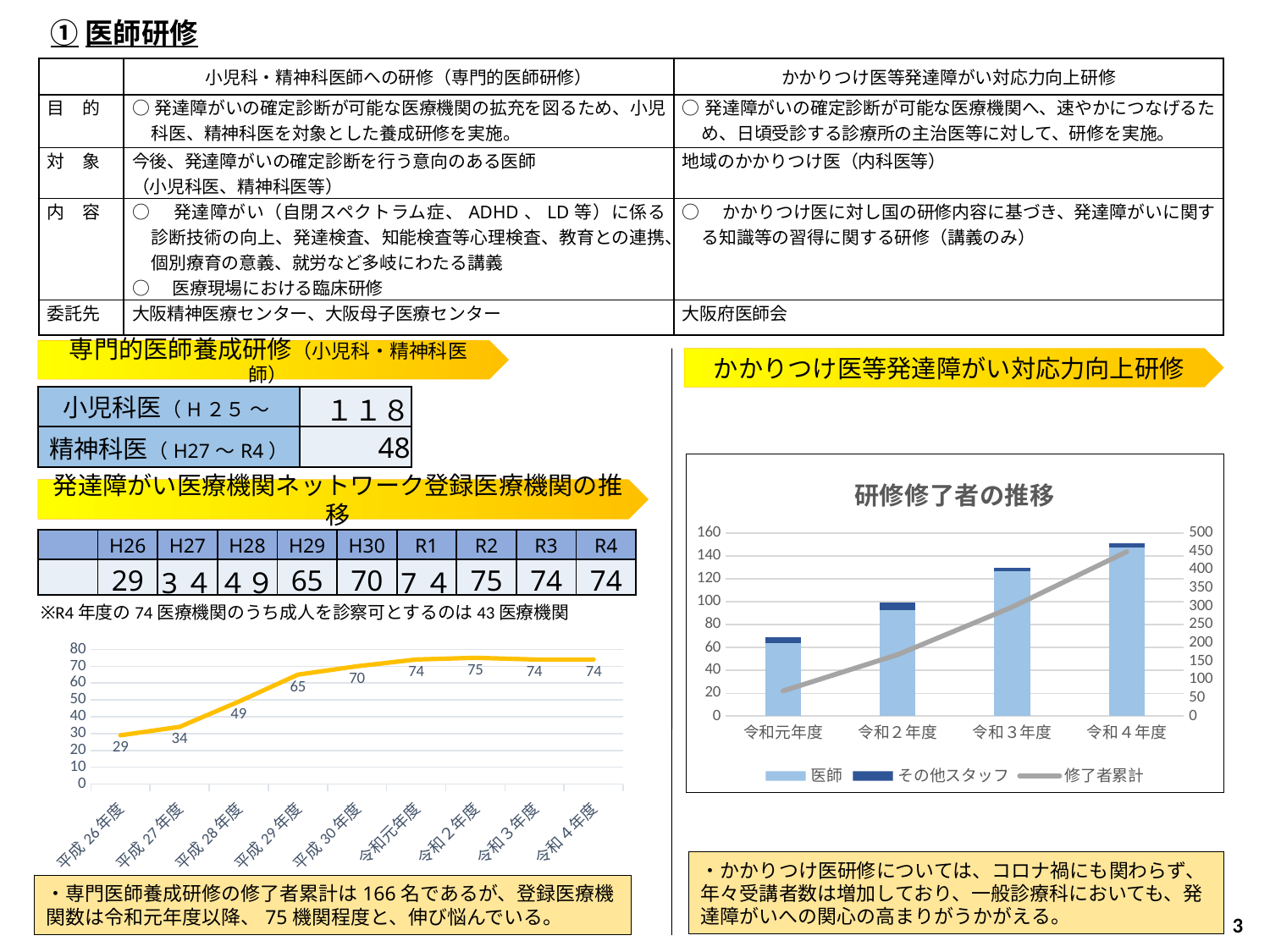
What kind of chart is the chart at the bottom left of the slide (the one with years from 平成26年度 to 令和4年度)? line chart In the bottom-left line chart, what is the difference between the values for 平成29年度 and 平成28年度? 16 In the chart titled 研修修了者の推移, is the total height of the stacked bar for 令和元年度 greater or less than 80? less In the bottom-left line chart, do the values generally rise or fall from 平成26年度 to 令和4年度? rise In the bottom-left line chart, which year has the highest value? 令和2年度 In the bottom-left line chart, what is the value for 平成28年度? 49 In the chart titled 研修修了者の推移, which year has the taller stacked bar, 令和元年度 or 令和3年度? 令和3年度 In the bottom-left line chart, which year has the lowest value? 平成26年度 How many series does the legend of the chart titled 研修修了者の推移 list? 3 What is the title of the chart on the right side of the slide? 研修修了者の推移 How many years (data points) are plotted in the bottom-left line chart? 9 In the bottom-left line chart, what is the value for 平成30年度? 70